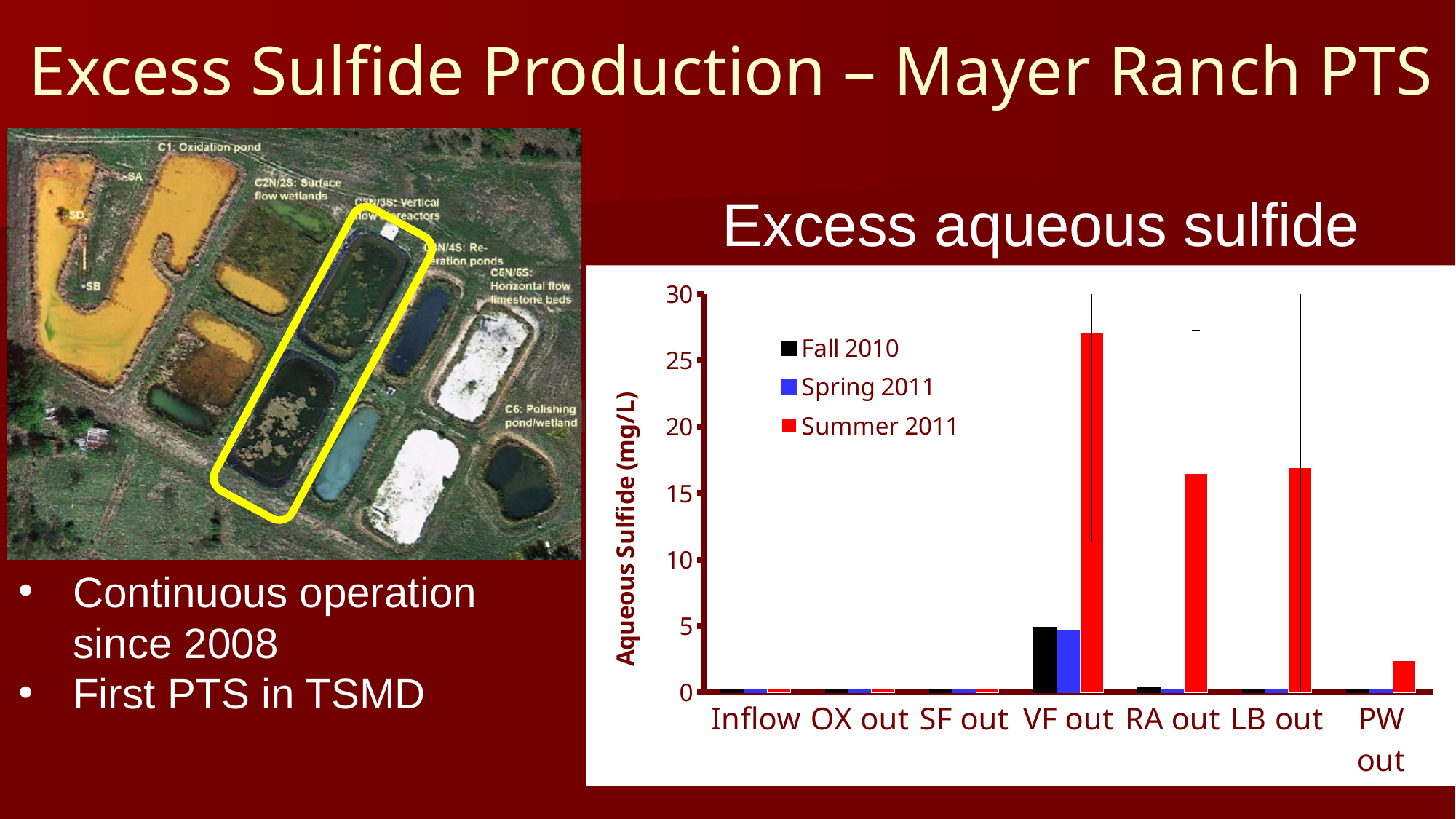
Is the Summer 2011 value for PW out greater or less than 5? less Which series is shown in red? Summer 2011 Is the Summer 2011 value for VF out greater or less than 25? greater How many series does the legend list? 3 Is the Summer 2011 value for LB out greater or less than 15? greater Which is larger, the Summer 2011 value for PW out or the Summer 2011 value for Inflow? PW out How many categories are shown on the x axis? 7 Which category has the highest Summer 2011 value? VF out What is the label of the y axis? Aqueous Sulfide (mg/L) Which is larger, the Summer 2011 value for VF out or the Summer 2011 value for RA out? VF out What kind of chart is shown on the slide? bar chart